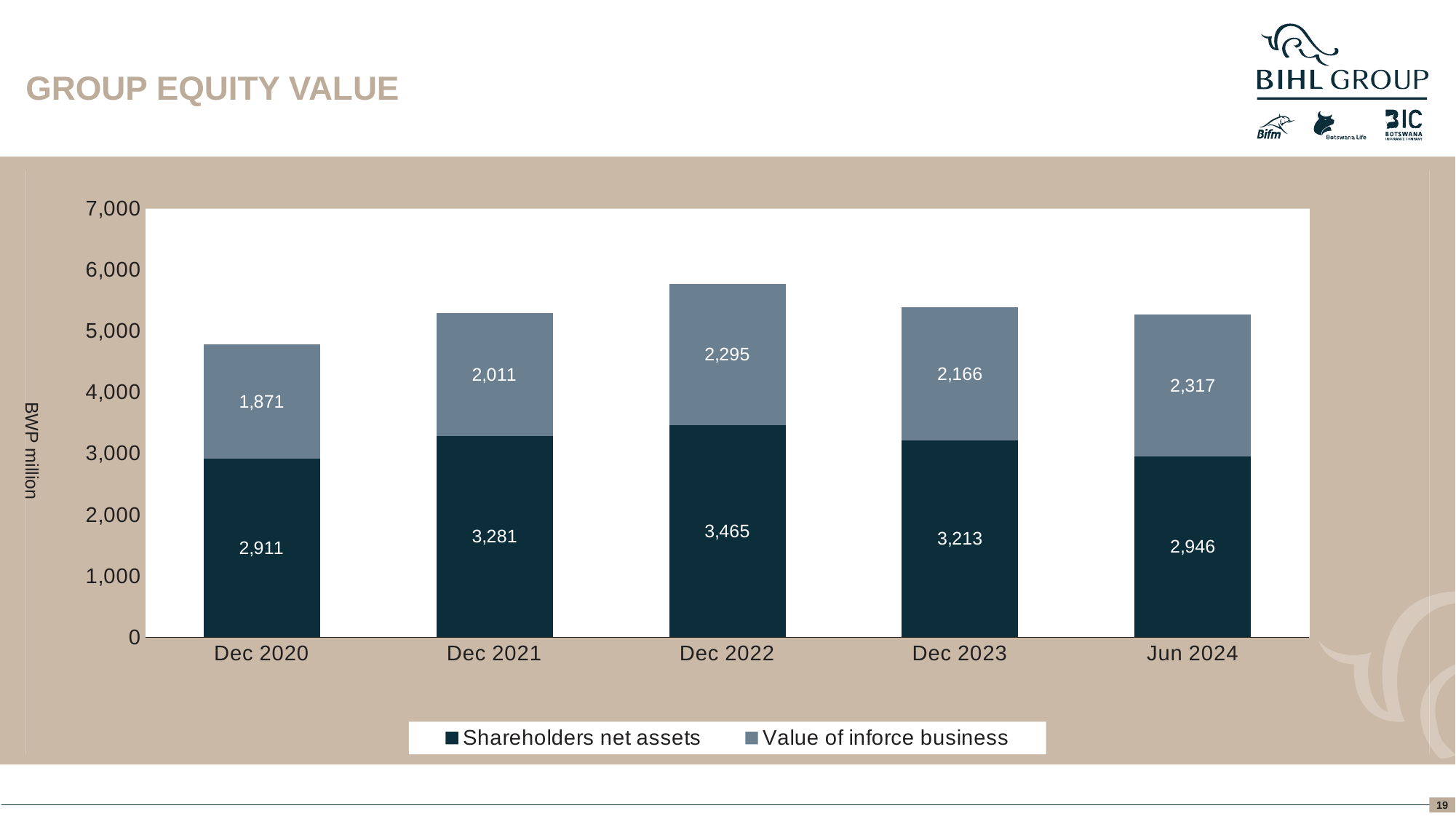
What is the value of Shareholders net assets for Dec 2022? 3,465 What is the total height of the stacked bar for Dec 2020? 4,782 Which period has the lowest Value of inforce business? Dec 2020 How many series does the legend list? 2 Which period has the highest Shareholders net assets? Dec 2022 What is the difference between Shareholders net assets in Dec 2022 and Dec 2020? 554 Which is larger: Shareholders net assets in Dec 2021 or in Dec 2023? Dec 2021 What kind of chart is shown on the slide? Stacked bar chart What is the Value of inforce business for Dec 2020? 1,871 What is the Value of inforce business for Jun 2024? 2,317 What is the total height of the stacked bar for Dec 2022? 5,760 How many periods are shown on the x axis? 5